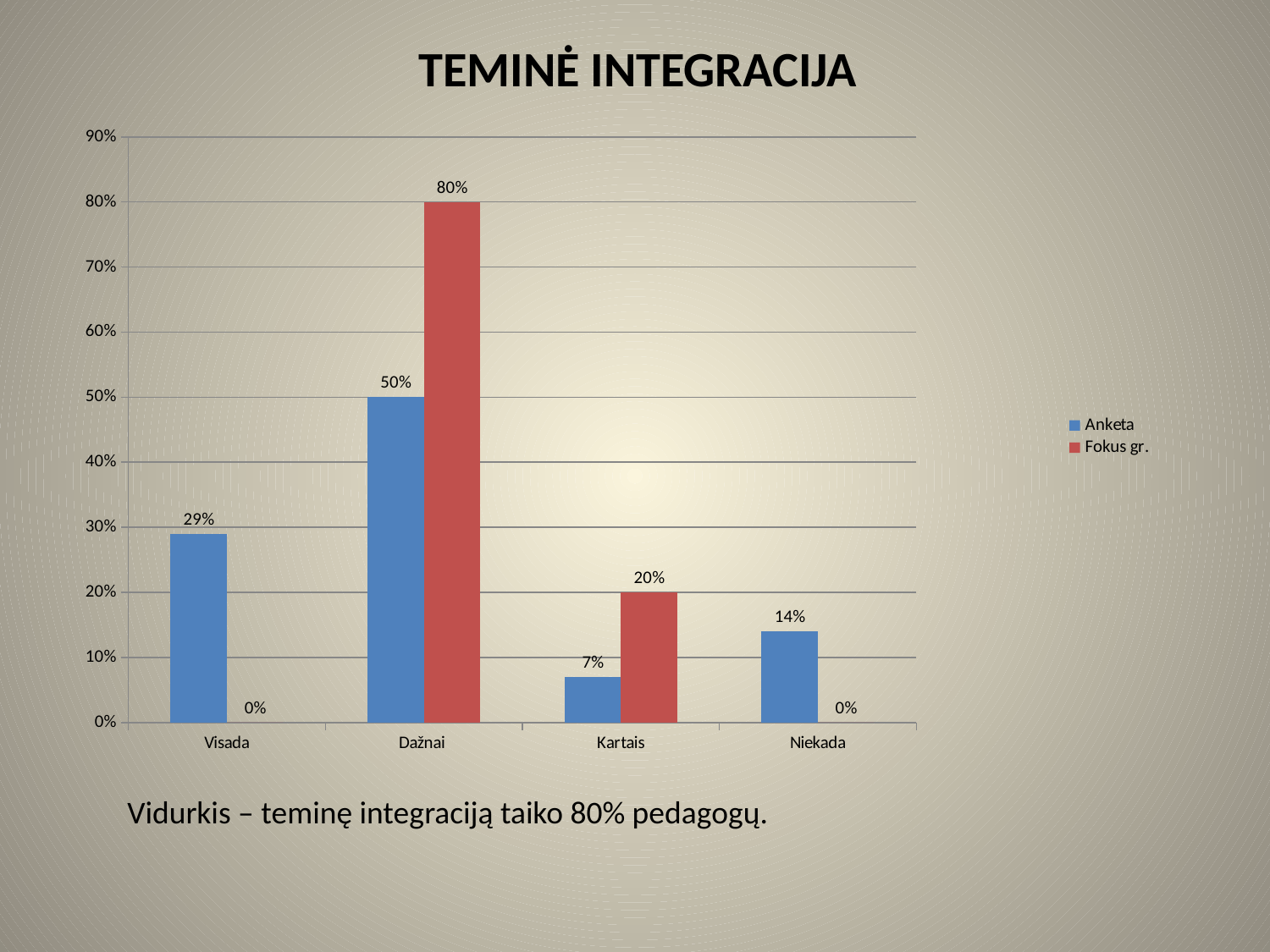
Which is larger for Kartais, the Anketa value or the Fokus gr. value? Fokus gr. How many series does the legend list? 2 What is the Fokus gr. value for Visada? 0% Which category has the highest Fokus gr. value? Dažnai Which category has the lowest Anketa value? Kartais What is the title of the chart? TEMINĖ INTEGRACIJA What is the Anketa value for Dažnai? 50% How many categories are shown on the x axis? 4 What kind of chart is shown on the slide? Bar chart What is the Fokus gr. value for Kartais? 20% What is the difference between the Fokus gr. and Anketa values for Dažnai? 30% What is the Anketa value for Niekada? 14%